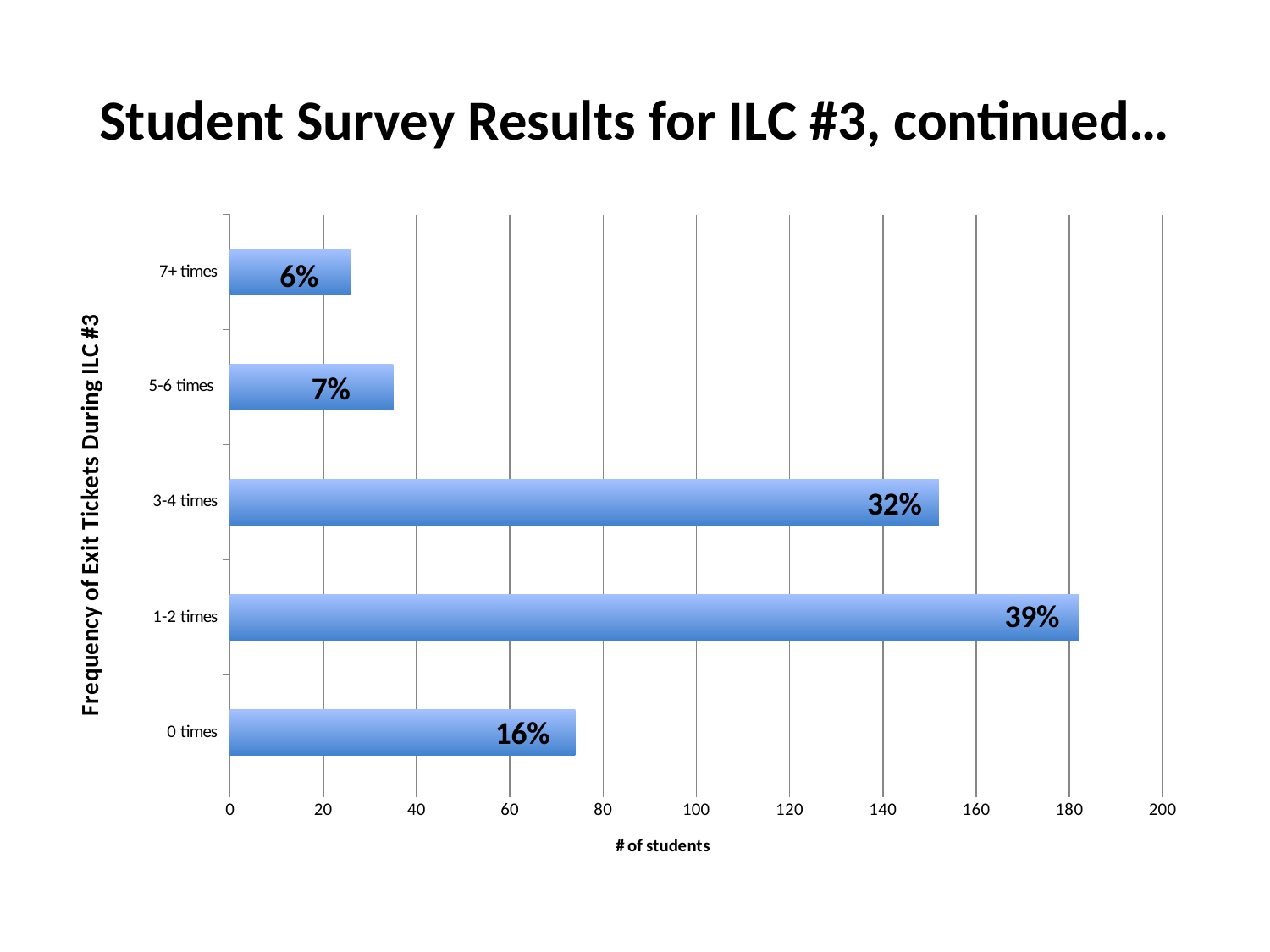
What percentage label is shown on the bar for 7+ times? 6% Is the number of students for 5-6 times greater or less than 40? less Is the number of students for 1-2 times greater or less than 160? greater Which bar is longer, 0 times or 3-4 times? 3-4 times What kind of chart is shown on the slide? bar chart Which frequency category has the shortest bar? 7+ times What percentage label is shown on the bar for 3-4 times? 32% What percentage label is shown on the bar for 1-2 times? 39% Which frequency category has the longest bar? 1-2 times What is the label of the horizontal axis? # of students How many frequency categories are shown on the chart? 5 What percentage label is shown on the bar for 0 times? 16%